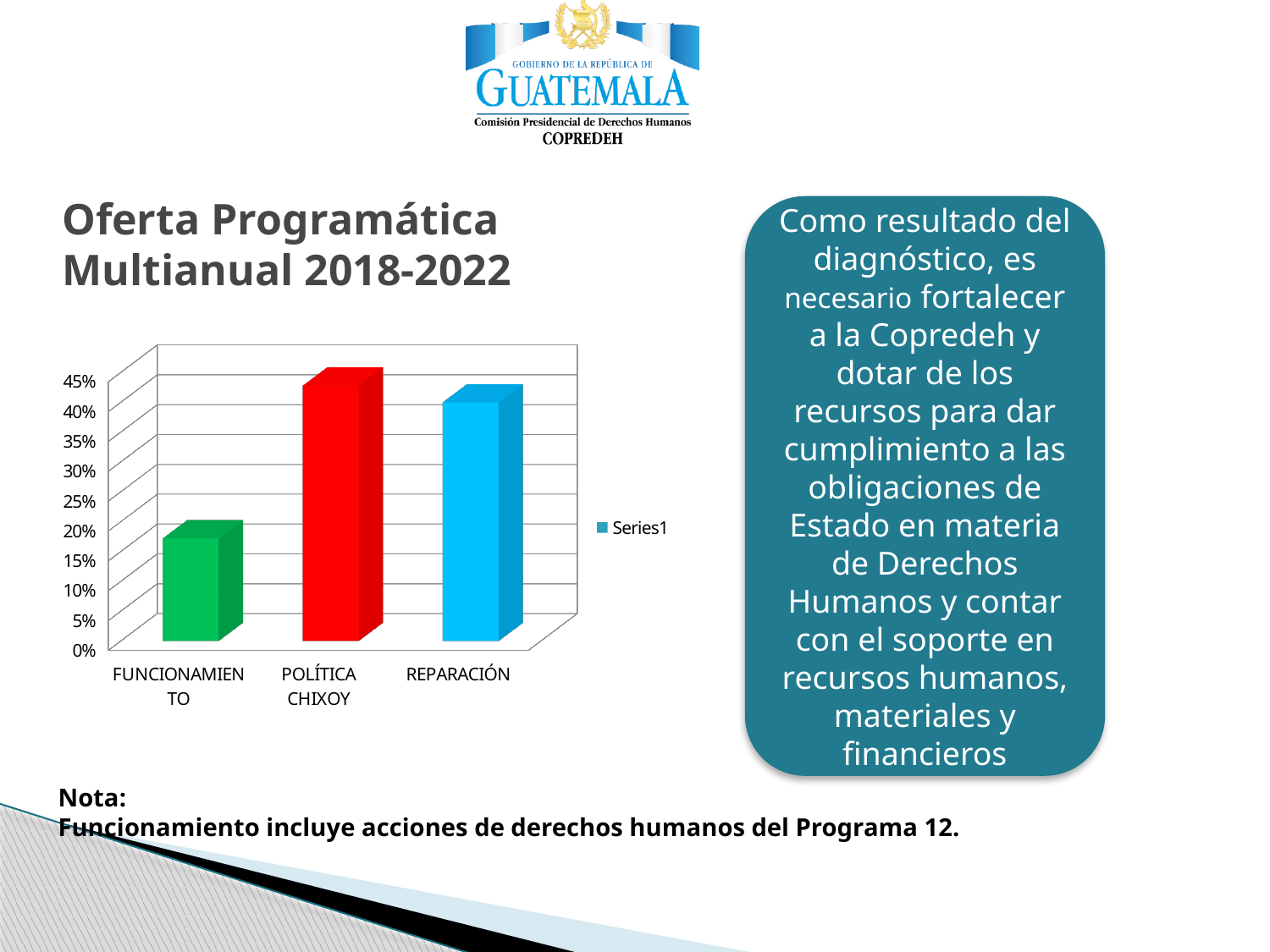
What colour is the bar for POLÍTICA CHIXOY? Red What is the name of the series shown in the chart legend? Series1 Which category has the lowest value in the chart? FUNCIONAMIENTO How many series does the chart legend list? 1 Is the value for REPARACIÓN greater or less than 30%? greater Which is larger, the value for POLÍTICA CHIXOY or the value for FUNCIONAMIENTO? POLÍTICA CHIXOY What kind of chart is shown on the slide? Bar chart Is the value for POLÍTICA CHIXOY greater or less than 35%? greater How many categories are plotted in the chart? 3 Is the value for FUNCIONAMIENTO greater or less than 25%? less Which category has the highest value in the chart? POLÍTICA CHIXOY Which is larger, the value for REPARACIÓN or the value for FUNCIONAMIENTO? REPARACIÓN